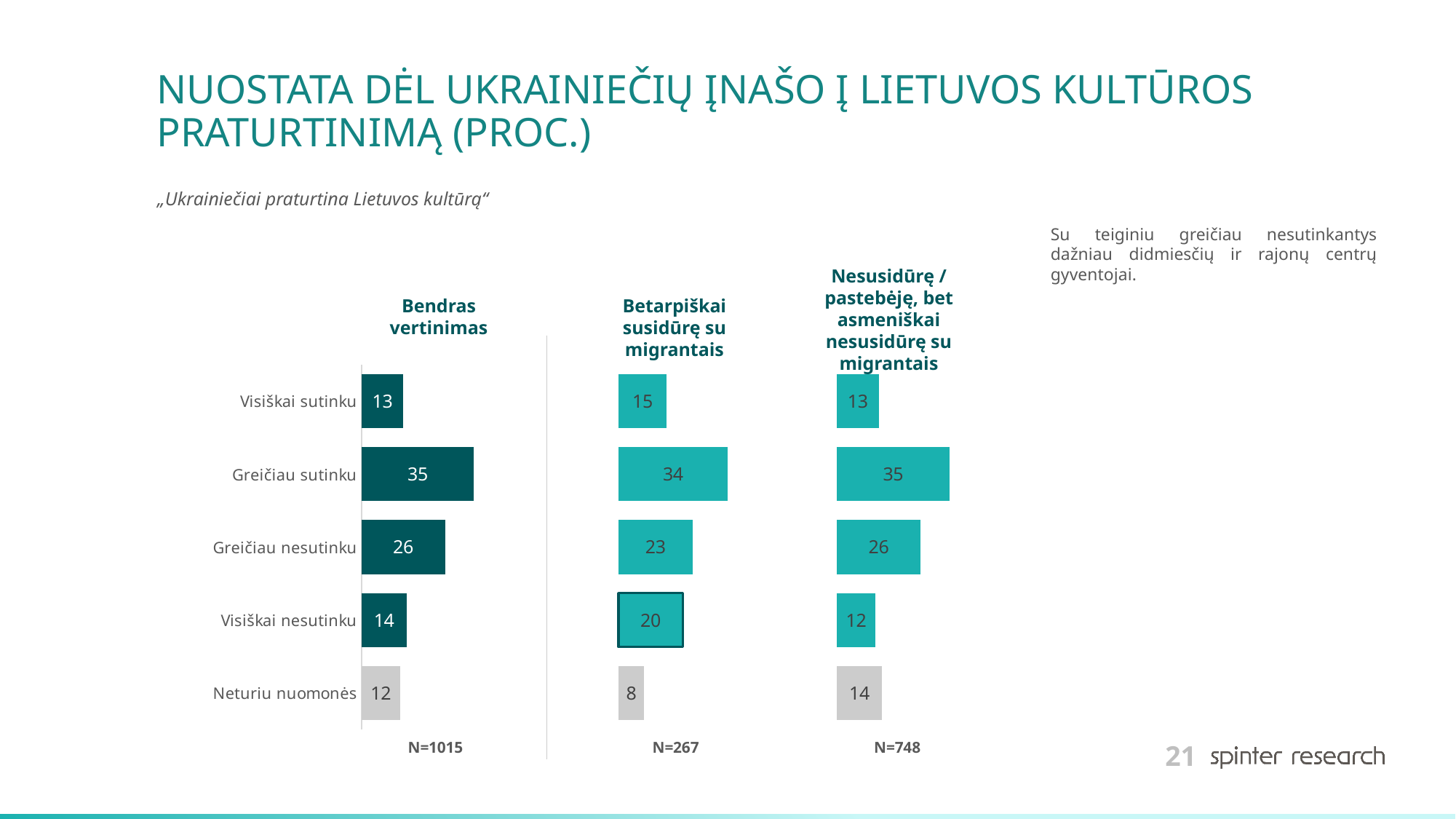
How many response categories are shown in the "Bendras vertinimas" chart? 5 Which is larger: "Visiškai nesutinku" in the "Betarpiškai susidūrę su migrantais" chart or "Visiškai nesutinku" in the "Nesusidūrę / pastebėję, bet asmeniškai nesusidūrę su migrantais" chart? Betarpiškai susidūrę su migrantais In the "Betarpiškai susidūrę su migrantais" chart, which category has the lowest value? Neturiu nuomonės In the "Nesusidūrę / pastebėję, bet asmeniškai nesusidūrę su migrantais" chart, what is the total of "Visiškai sutinku" and "Greičiau sutinku"? 48 What statement is quoted above the charts? „Ukrainiečiai praturtina Lietuvos kultūrą“ What type of chart is used on this slide? Bar chart What is the sample size (N) shown under the "Betarpiškai susidūrę su migrantais" chart? N=267 In the "Betarpiškai susidūrę su migrantais" chart, what is the value for "Visiškai nesutinku"? 20 In the "Nesusidūrę / pastebėję, bet asmeniškai nesusidūrę su migrantais" chart, what is the value for "Neturiu nuomonės"? 14 In the "Bendras vertinimas" chart, what is the value for "Greičiau sutinku"? 35 In the "Betarpiškai susidūrę su migrantais" chart, which category has the highest value? Greičiau sutinku In the "Bendras vertinimas" chart, what is the difference between "Greičiau sutinku" and "Greičiau nesutinku"? 9